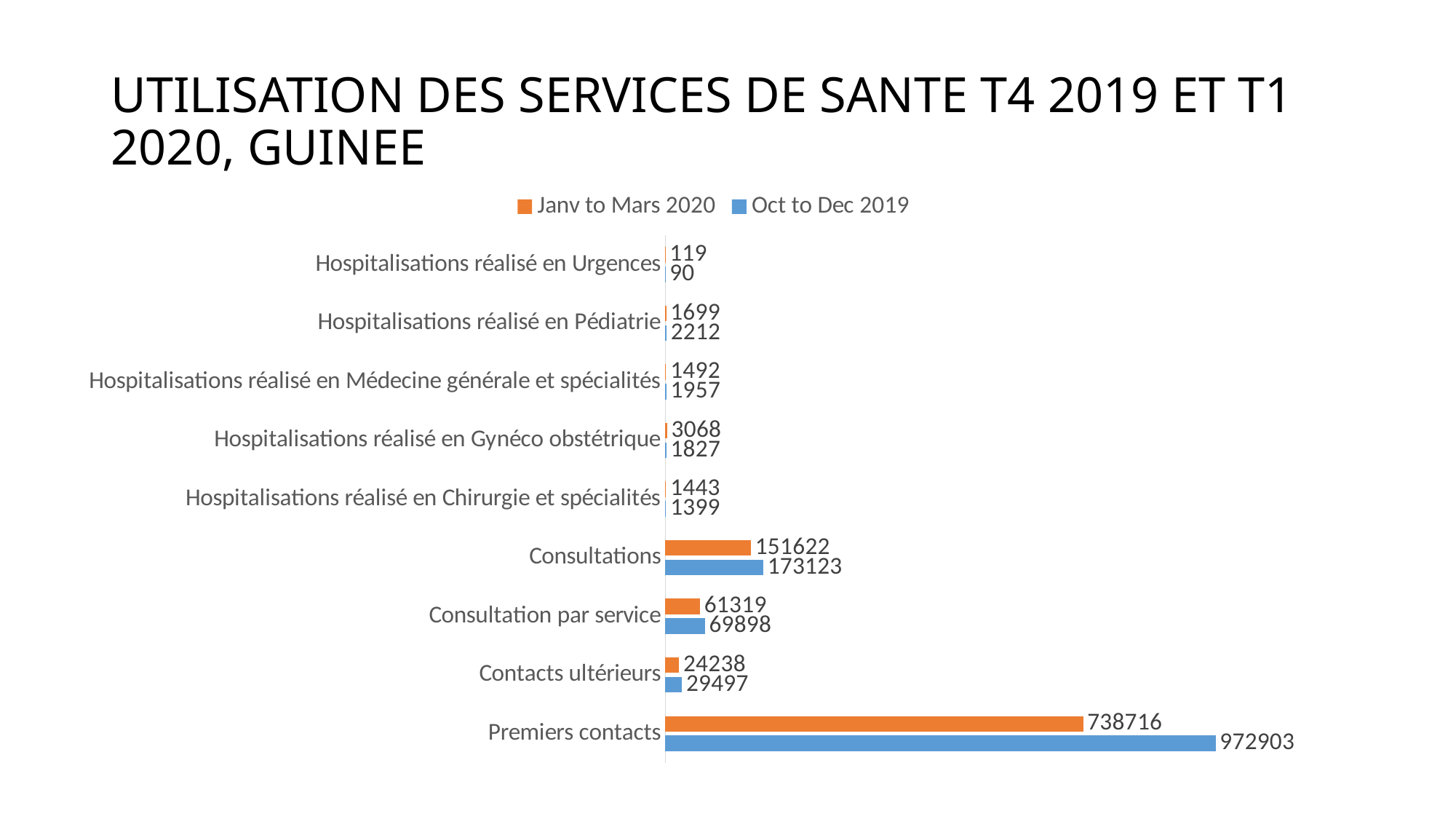
What is the difference between the Oct to Dec 2019 and Janv to Mars 2020 values for Premiers contacts? 234187 How many series does the legend list? 2 What is the value for Hospitalisations réalisé en Urgences in the Oct to Dec 2019 series? 90 For Hospitalisations réalisé en Gynéco obstétrique, which series has the larger value, Janv to Mars 2020 or Oct to Dec 2019? Janv to Mars 2020 What is the value for Consultations in the Janv to Mars 2020 series? 151622 What kind of chart is shown on the slide? Bar chart Which colour represents the Oct to Dec 2019 series? Blue Which category has the lowest value in the Oct to Dec 2019 series? Hospitalisations réalisé en Urgences What is the value for Premiers contacts in the Oct to Dec 2019 series? 972903 How many categories are shown on the chart? 9 What is the difference between the Oct to Dec 2019 and Janv to Mars 2020 values for Contacts ultérieurs? 5259 Which category has the highest value in the Janv to Mars 2020 series? Premiers contacts